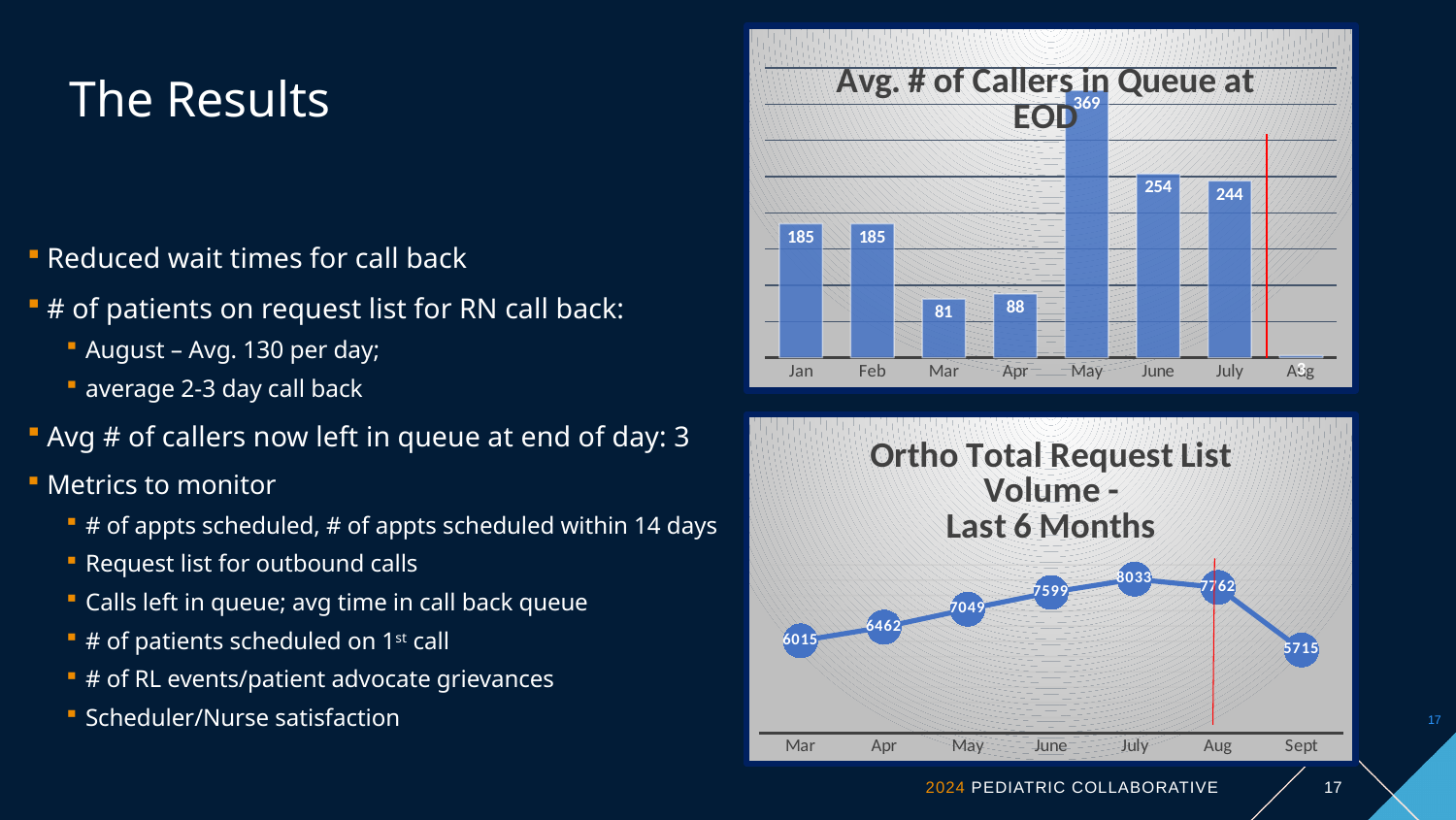
In the 'Avg. # of Callers in Queue at EOD' chart, what is the value for Mar? 81 In the 'Ortho Total Request List Volume - Last 6 Months' chart, what is the value for July? 8033 In the 'Avg. # of Callers in Queue at EOD' chart, what is the value for May? 369 In the 'Avg. # of Callers in Queue at EOD' chart, how many months are shown on the x axis? 8 What kind of chart is 'Ortho Total Request List Volume - Last 6 Months'? Line chart In the 'Ortho Total Request List Volume - Last 6 Months' chart, what is the difference between the Apr and Mar values? 447 In the 'Avg. # of Callers in Queue at EOD' chart, which is larger, the value for Apr or the value for Mar? Apr In the 'Ortho Total Request List Volume - Last 6 Months' chart, which month has the lowest value? Sept In the 'Avg. # of Callers in Queue at EOD' chart, what is the difference between the June and July values? 10 In the 'Ortho Total Request List Volume - Last 6 Months' chart, what is the value for Sept? 5715 In the 'Avg. # of Callers in Queue at EOD' chart, which month has the highest value? May What kind of chart is 'Avg. # of Callers in Queue at EOD'? Bar chart